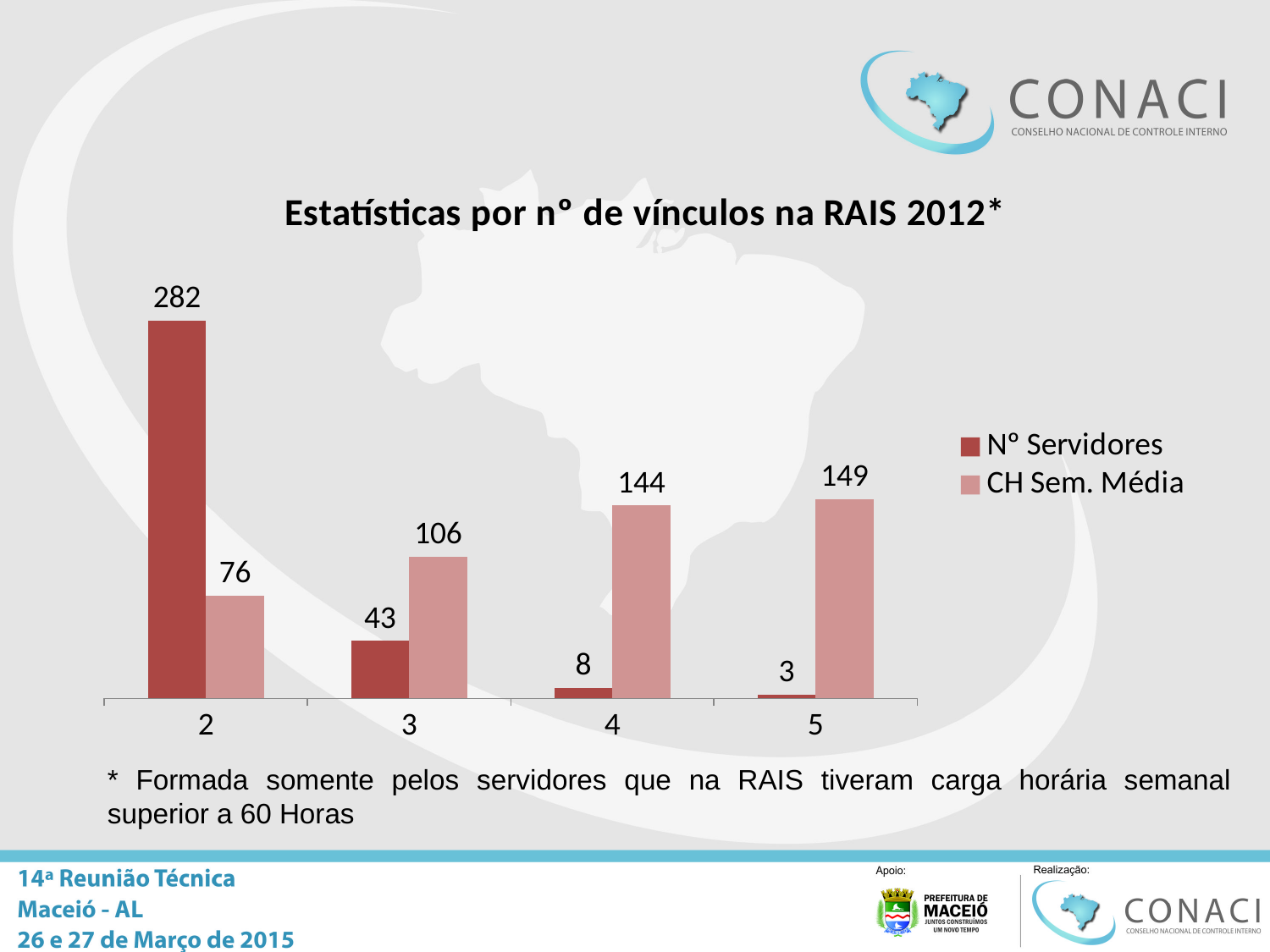
What is the difference between Nº Servidores for category 2 and category 3? 239 Which category has the lowest value for Nº Servidores? 5 What is the title of the chart? Estatísticas por nº de vínculos na RAIS 2012* How many categories are shown on the x axis? 4 Do the Nº Servidores values rise or fall from category 2 to category 5? Fall What is the value of Nº Servidores for category 2? 282 What is the value of Nº Servidores for category 5? 3 Which category has the highest value for CH Sem. Média? 5 How many series does the legend list? 2 What is the value of CH Sem. Média for category 4? 144 Which is larger: CH Sem. Média for category 3 or Nº Servidores for category 3? CH Sem. Média for category 3 What kind of chart is shown on the slide? Bar chart